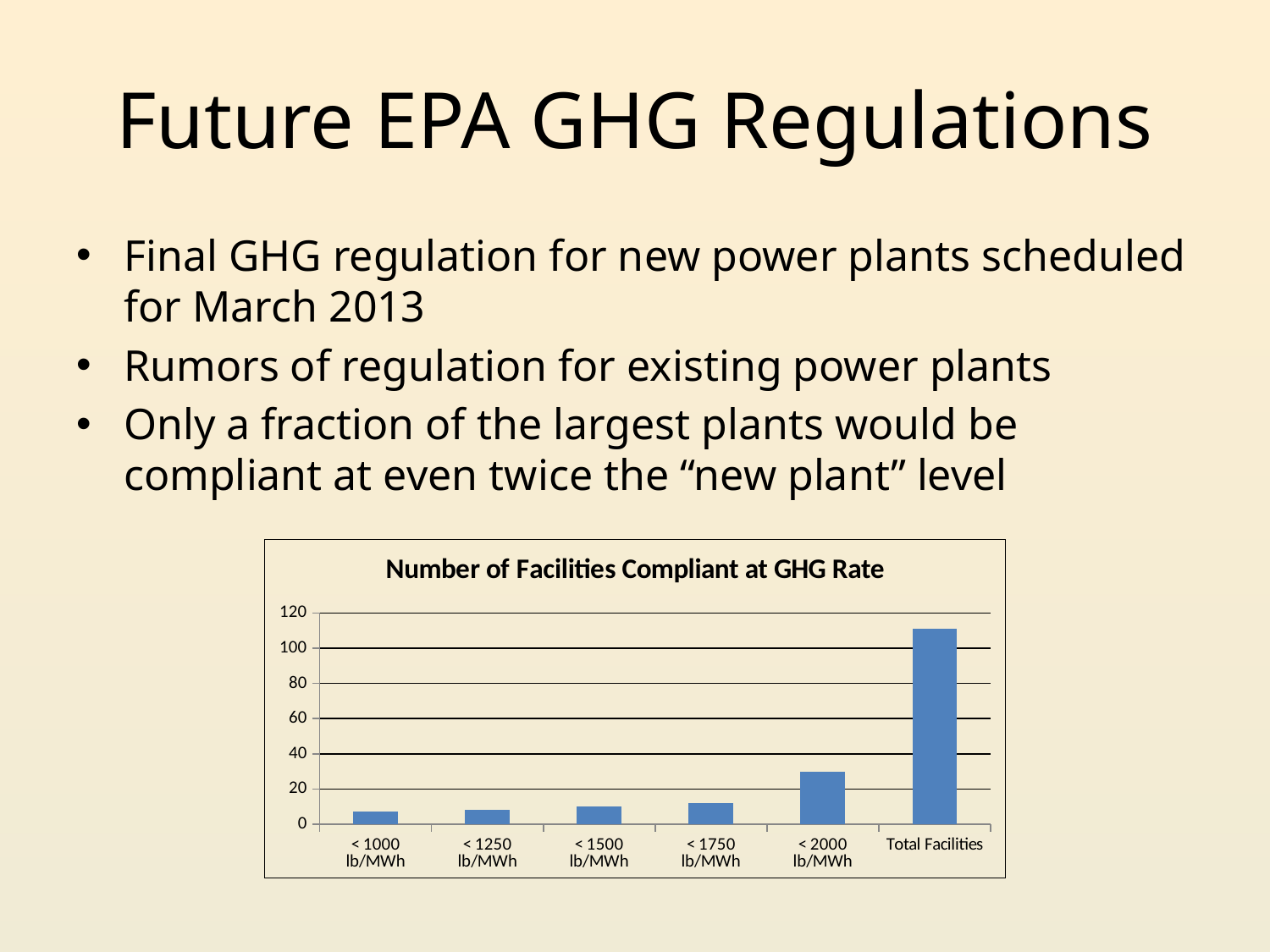
What is the title of the chart? Number of Facilities Compliant at GHG Rate Which is larger, the value for < 2000 lb/MWh or the value for < 1750 lb/MWh? < 2000 lb/MWh What kind of chart is shown on the slide? bar chart Is the value for < 1750 lb/MWh greater or less than 20? less Which category has the highest bar in the chart? Total Facilities Is the value for < 2000 lb/MWh greater or less than 20? greater How many categories are shown on the x axis of the chart? 6 Which is larger, the value for Total Facilities or the value for < 2000 lb/MWh? Total Facilities Is the value for Total Facilities greater or less than 100? greater Do the bar values rise or fall moving from left to right along the x axis? rise